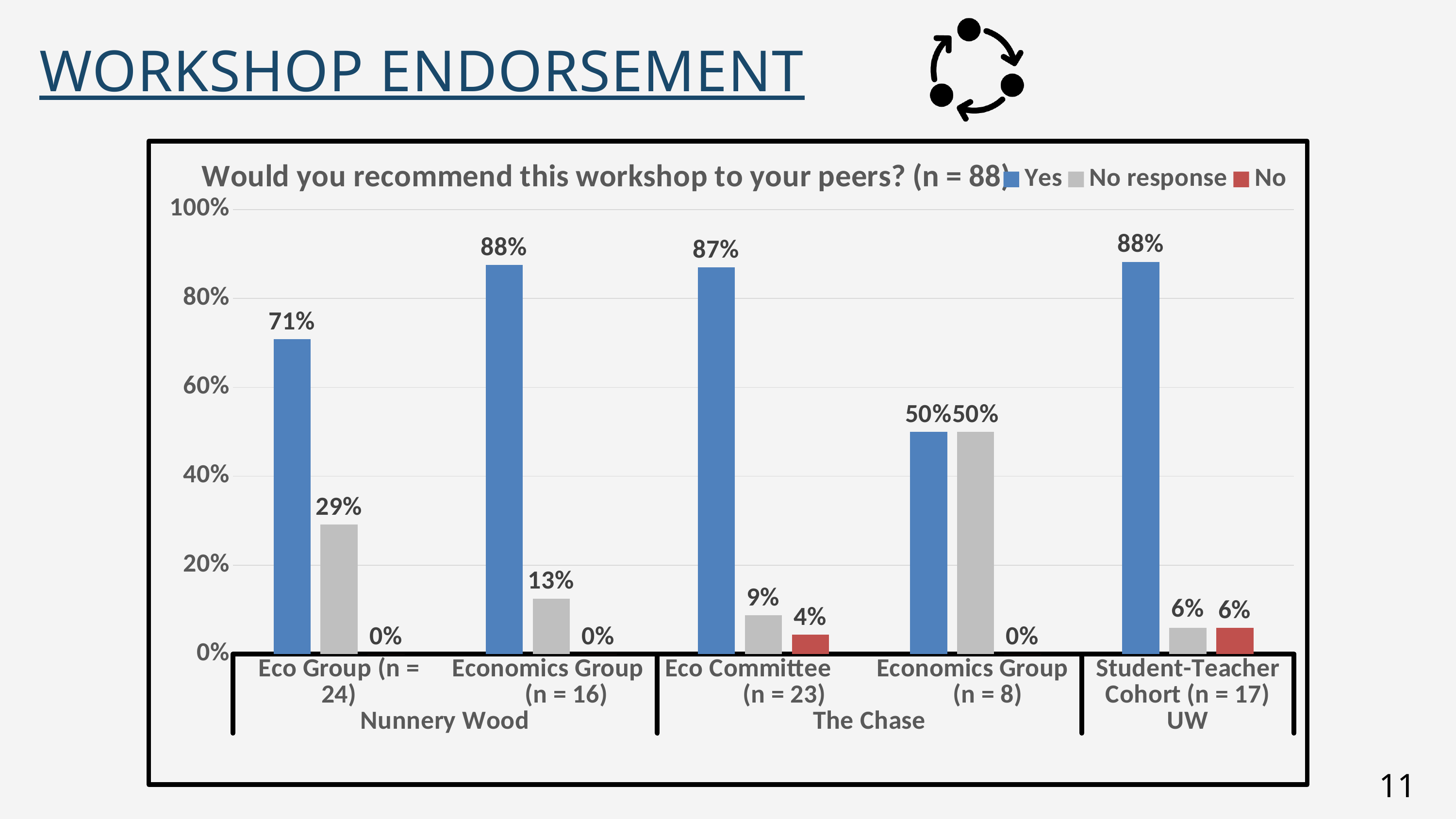
Which group has the lowest Yes percentage? Economics Group (n = 8), The Chase What is the No response value for the Economics Group (n = 16) at Nunnery Wood? 13% What percentage of the Eco Group (n = 24) at Nunnery Wood answered Yes? 71% Which group has the highest No response percentage? Economics Group (n = 8), The Chase What is the title of the chart? Would you recommend this workshop to your peers? (n = 88) How many groups (categories) are plotted along the x axis? 5 What is the difference between the Yes and No response values for the Eco Group (n = 24) at Nunnery Wood? 42% Which is larger for the Student-Teacher Cohort (n = 17): the Yes value or the No response value? Yes What kind of chart is shown on the slide? bar chart Is the Yes value for the Eco Committee (n = 23) greater or less than 80%? greater What is the No value for the Eco Committee (n = 23) at The Chase? 4% How many series does the legend list? 3